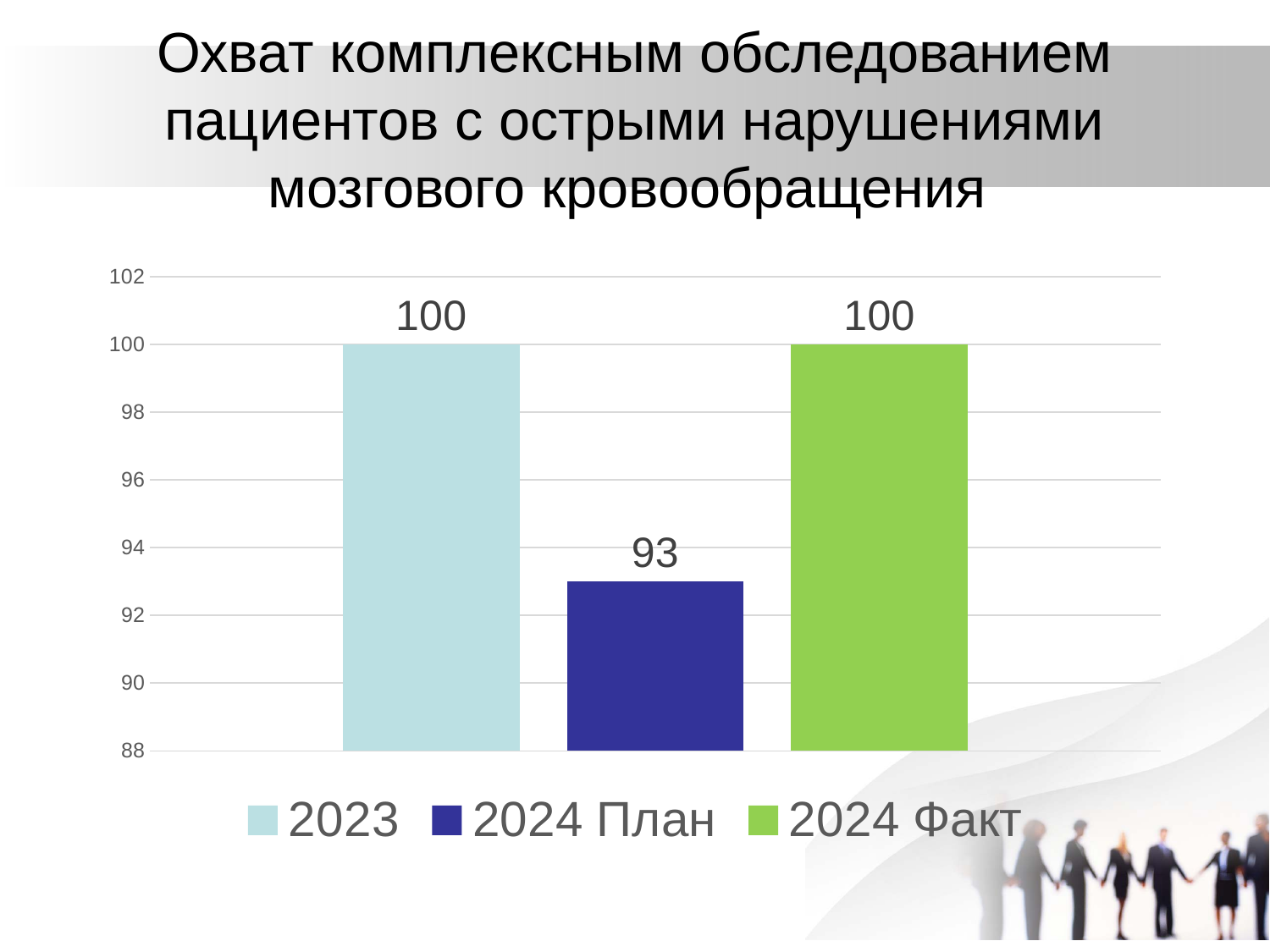
What is the value for 2023? 100 What colour is the bar for 2024 Факт? green What is the value for 2024 Факт? 100 How many bars are plotted on the chart? 3 Which is larger, the value for 2023 or the value for 2024 План? 2023 What kind of chart is shown on the slide? bar chart Is the value for 2024 План greater or less than 96? less Which series has the lowest value? 2024 План What is the highest value shown on the vertical axis? 102 What is the value for 2024 План? 93 What is the difference between the 2024 Факт value and the 2024 План value? 7 How many series does the legend list? 3